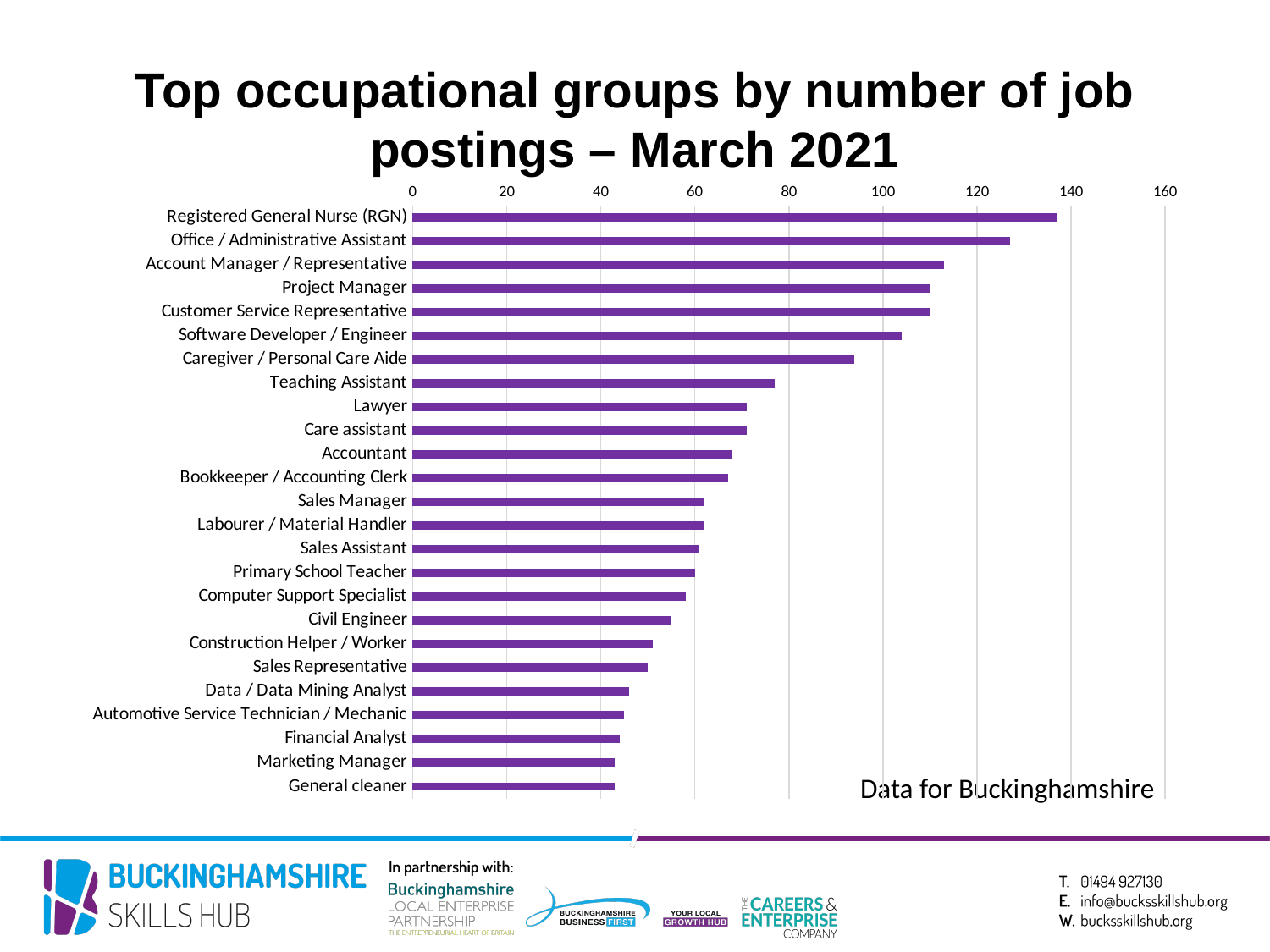
Is the value for Civil Engineer greater or less than 60? less Which occupational group has the highest number of job postings? Registered General Nurse (RGN) What kind of chart is shown on the slide? Bar chart Is the value for Caregiver / Personal Care Aide greater or less than 100? less Is the value for Software Developer / Engineer greater or less than 100? greater What is the title of the chart? Top occupational groups by number of job postings – March 2021 Which has more job postings, Registered General Nurse (RGN) or Office / Administrative Assistant? Registered General Nurse (RGN) Do the bar values increase or decrease going from the top of the chart to the bottom? Decrease Which has more job postings, Caregiver / Personal Care Aide or Teaching Assistant? Caregiver / Personal Care Aide How many occupational groups are plotted in the chart? 25